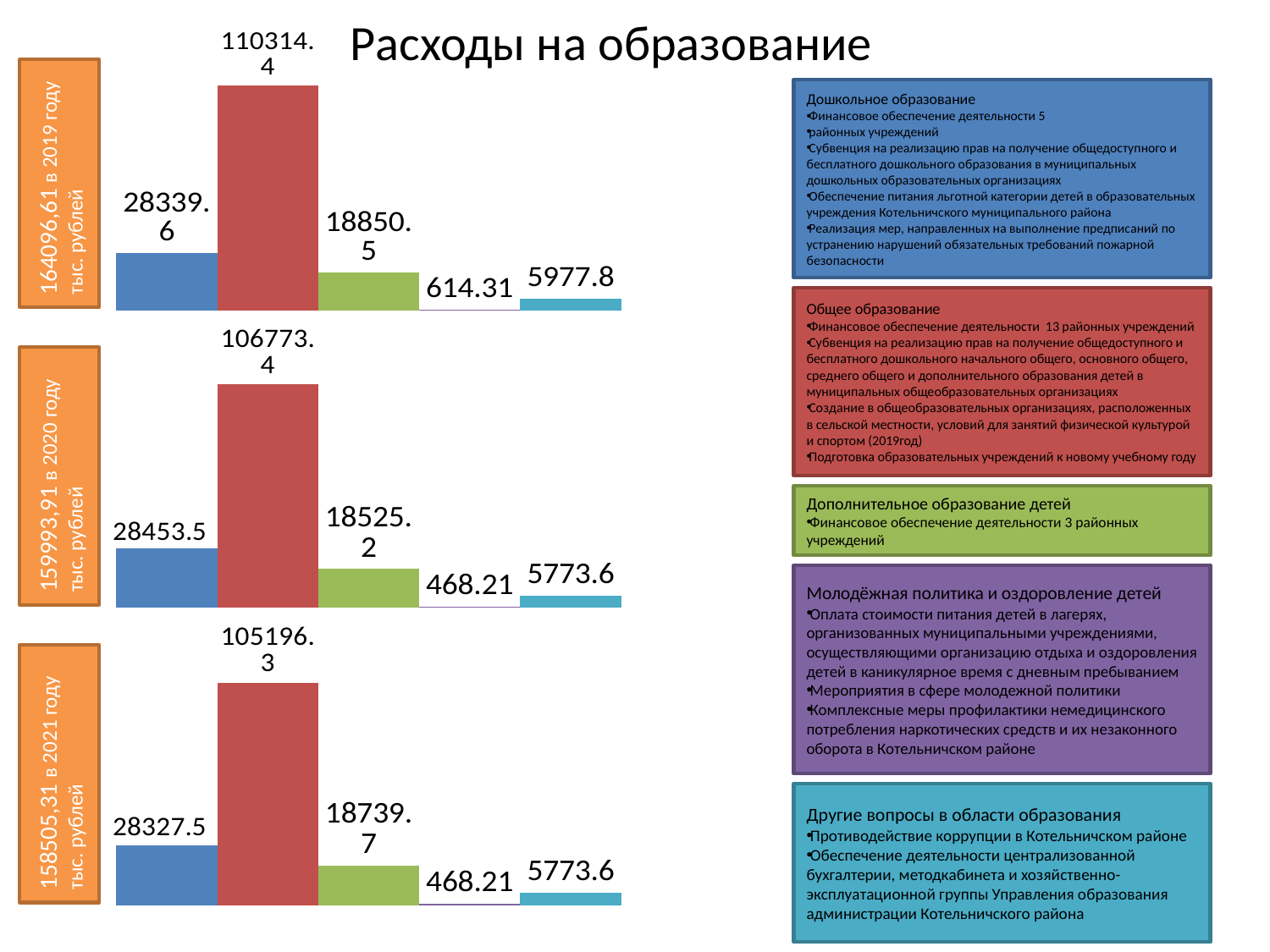
In the bottom chart (2021), what is the value of the green bar (Дополнительное образование детей)? 18739.7 Which is larger: the red bar in the 2019 chart or the red bar in the 2021 chart? The 2019 chart (110314.4) How many bars are shown in the middle chart (2020)? 5 In the middle chart (2020), which category has the lowest value? Молодёжная политика и оздоровление детей What is the title of the slide? Расходы на образование In the top chart (2019), what is the value of the purple bar (Молодёжная политика и оздоровление детей)? 614.31 In the bottom chart (2021), what is the difference between the cyan bar (5773.6) and the purple bar (468.21)? 5305.39 What type of chart is used for the 2019 data? Bar chart In the top chart (2019), what is the value of the red bar (Общее образование)? 110314.4 In the top chart (2019), what is the difference between the red bar (110314.4) and the blue bar (28339.6)? 81974.8 In the middle chart (2020), what is the value of the blue bar (Дошкольное образование)? 28453.5 In the bottom chart (2021), which category has the highest value? Общее образование